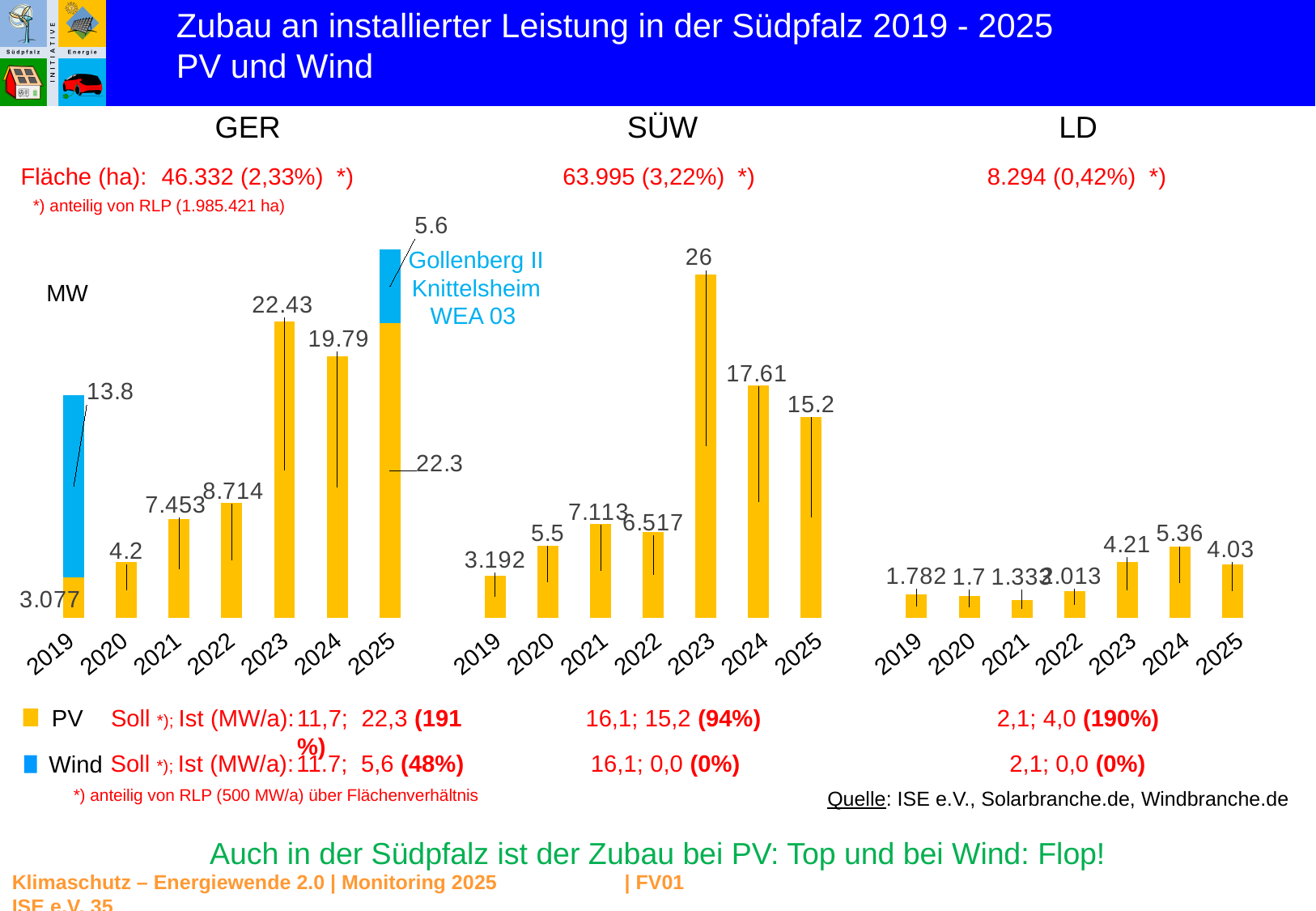
In the GER chart, what is the total of the stacked bar for 2025? 27.9 In the LD chart, is the value for 2023 larger than the value for 2025? Yes In the GER chart, what is the PV value for 2025? 22.3 In the SÜW chart, what is the value for 2023? 26 In the LD chart, which year has the lowest value? 2021 What type of chart is used for the GER, SÜW and LD data? Bar chart In the LD chart, what is the value for 2024? 5.36 In the GER chart, what is the Wind value for 2019? 13.8 In the SÜW chart, what is the difference between the values for 2023 and 2024? 8.39 How many series does the legend list? 2 In the SÜW chart, which year has the highest value? 2023 How many years are shown on the x axis of the SÜW chart? 7